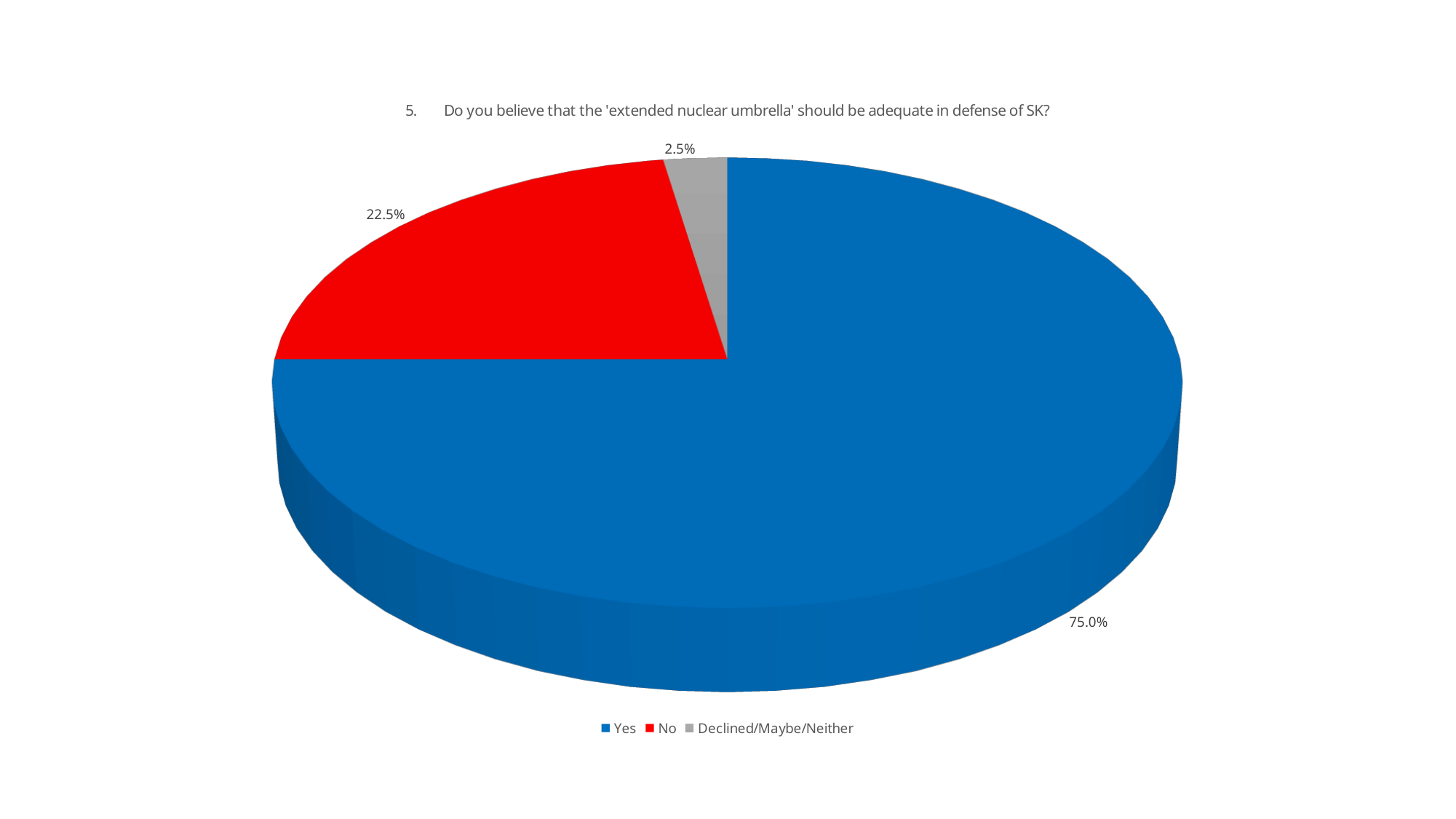
How many entries does the legend list? 3 What percentage of respondents answered 'No'? 22.5% Which category has the largest share of the pie? Yes How many categories does the pie chart show? 3 What is the difference in percentage points between the 'Yes' and 'No' shares? 52.5 What percentage of respondents answered 'Yes'? 75.0% Which category has the smallest share of the pie? Declined/Maybe/Neither What kind of chart is shown on the slide? Pie chart What percentage of respondents are in the 'Declined/Maybe/Neither' category? 2.5% What is the title of the chart? 5. Do you believe that the 'extended nuclear umbrella' should be adequate in defense of SK? What colour is the 'No' slice? Red Which is larger, the 'No' share or the 'Declined/Maybe/Neither' share? No